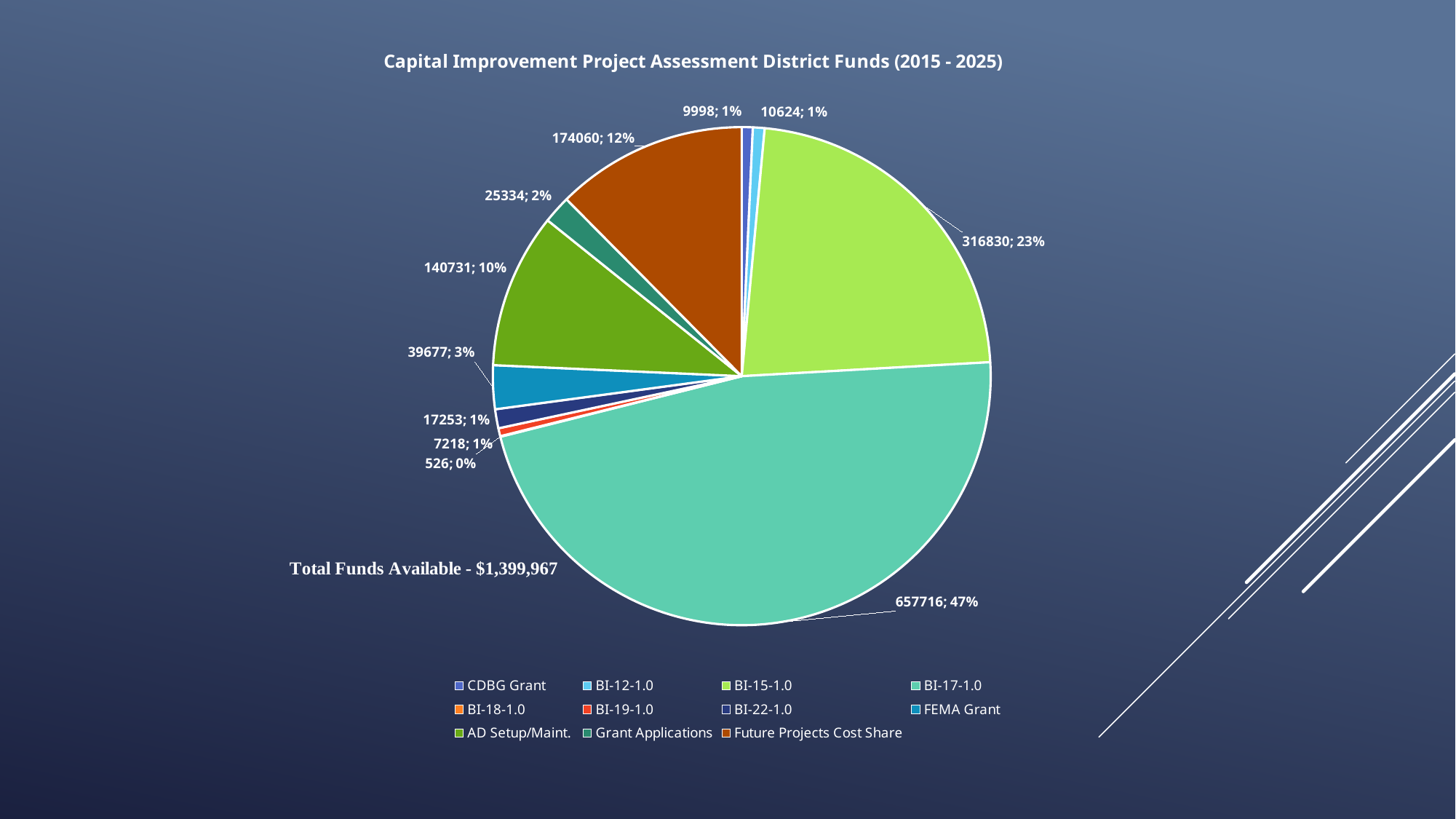
Which category has the largest slice? BI-17-1.0 What share of the pie does BI-15-1.0 represent? 23% How many categories does the legend list? 11 Which is larger, the value for FEMA Grant or the value for Grant Applications? FEMA Grant What is the value for BI-17-1.0? 657716 What is the value for Future Projects Cost Share? 174060 What is the title of the chart? Capital Improvement Project Assessment District Funds (2015 - 2025) What is the difference between the values for BI-17-1.0 and BI-15-1.0? 340886 What type of chart is shown on the slide? pie chart Which category has the smallest slice? BI-18-1.0 What share of the pie does AD Setup/Maint. represent? 10% What total funds available amount is stated on the slide? $1,399,967